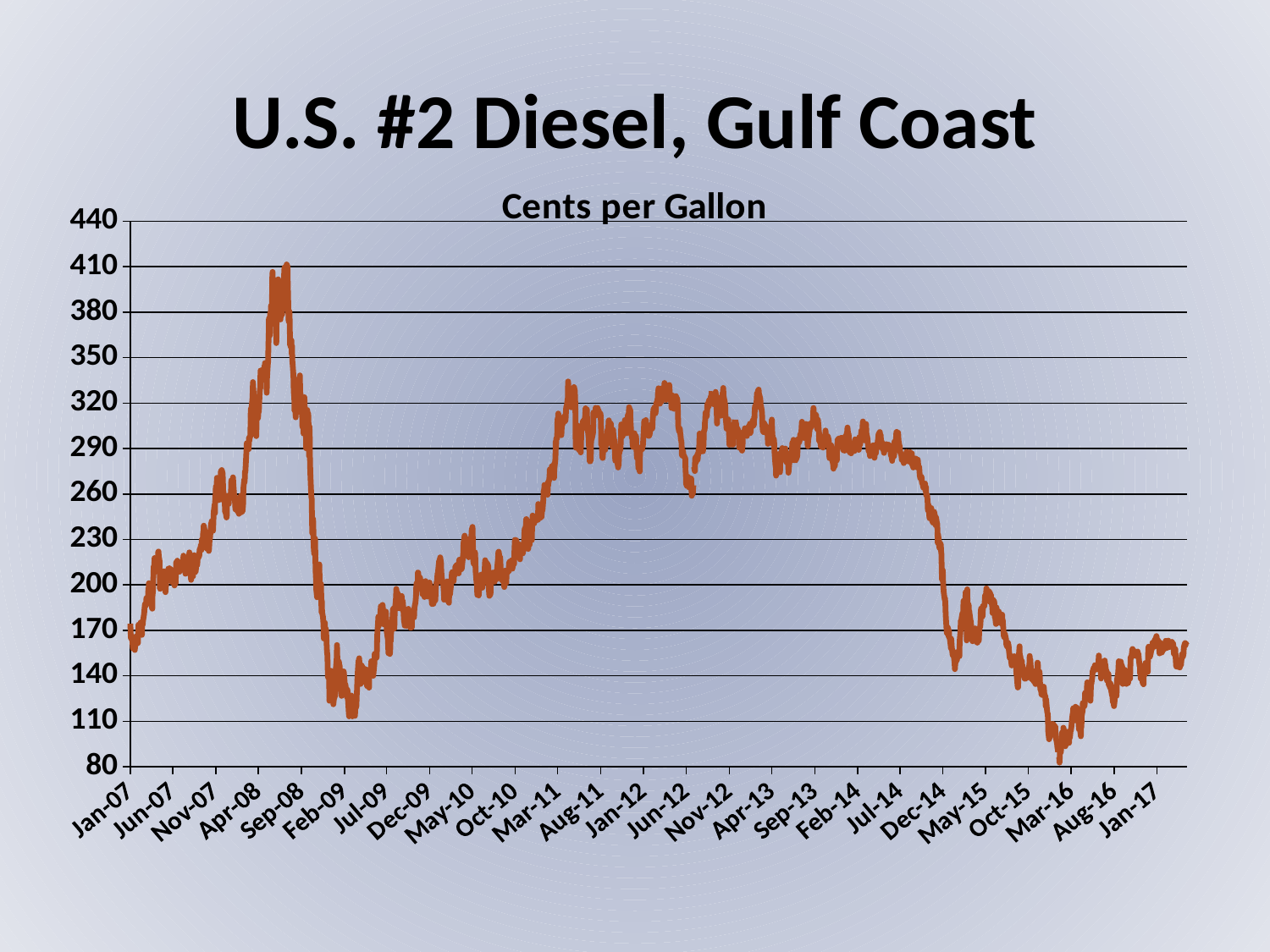
Is the value around Jan-12 greater or less than 260? greater Is the value at Jan-07 greater or less than 200? less Around which x-axis label does the line reach its highest point? Sep-08 What unit is the chart's vertical axis measured in, according to the subtitle? Cents per Gallon Do the values rise or fall between Sep-08 and Feb-09? fall Around which x-axis label does the line reach its lowest point? Mar-16 What kind of chart is shown on the slide? Line chart Is the value around Mar-16 greater or less than 110? less Do the values rise or fall between Mar-16 and Jan-17? rise What is the title of the chart? U.S. #2 Diesel, Gulf Coast